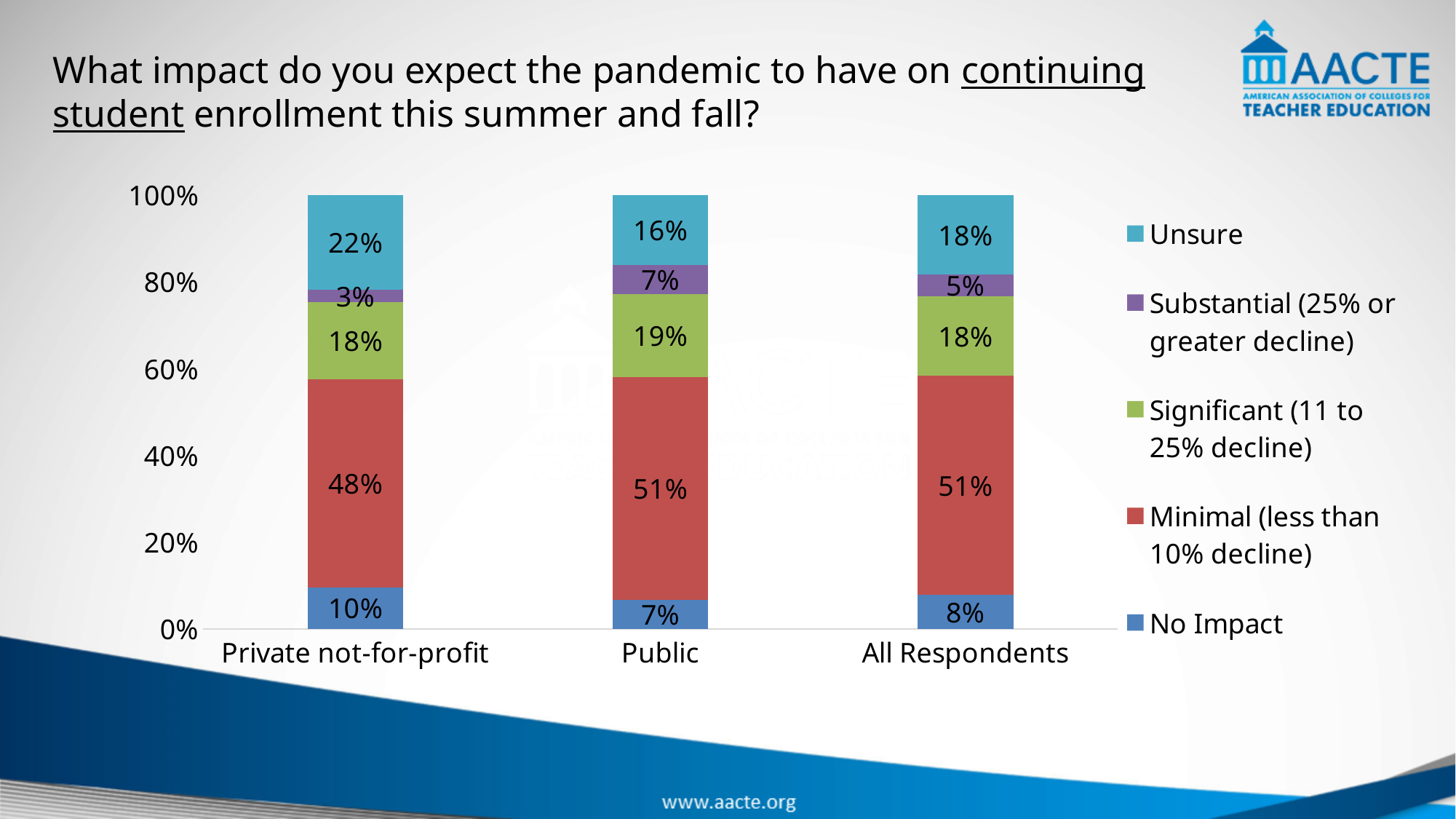
What is the value for Substantial (25% or greater decline) in the Private not-for-profit bar? 3% What kind of chart is shown on the slide? Stacked bar chart What is the value for Minimal (less than 10% decline) in the Public bar? 51% What is the difference between the Minimal (less than 10% decline) values for Public and Private not-for-profit? 3% How many series does the legend list? 5 Which category has the highest value for Unsure? Private not-for-profit What is the value for No Impact for All Respondents? 8% How many categories are shown on the x axis? 3 Which category has the lowest value for No Impact? Public Which legend entry is shown in red? Minimal (less than 10% decline) Which is larger: the Substantial (25% or greater decline) value for Public or for All Respondents? Public What is the value for Unsure in the Private not-for-profit bar? 22%